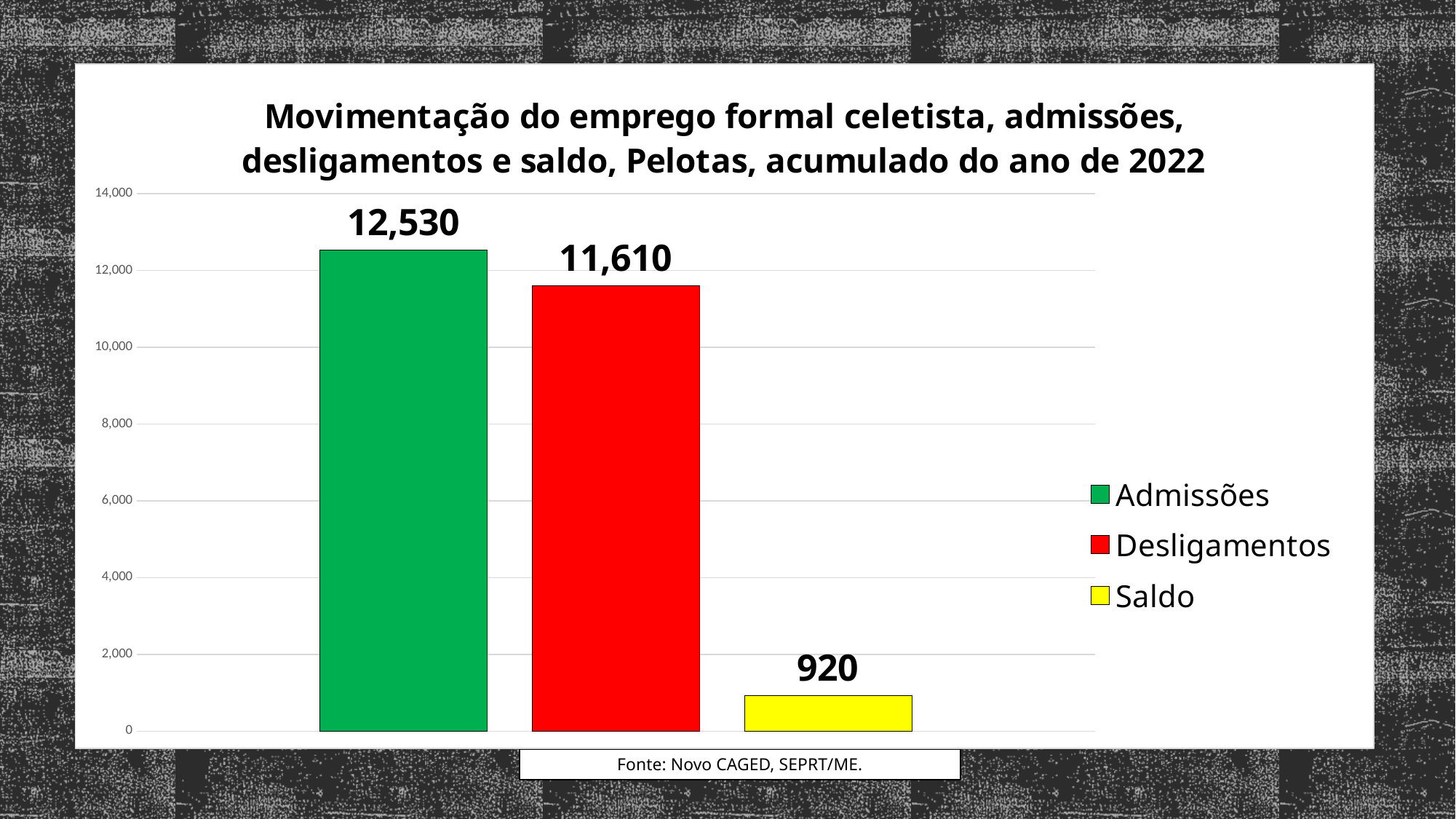
What colour is the bar for Saldo? yellow What is the difference between Admissões and Desligamentos? 920 What is the value for Saldo? 920 Which category has the highest value? Admissões What kind of chart is shown on the slide? bar chart Which category has the lowest value? Saldo Is the value for Desligamentos greater or less than 12,000? less What is the value for Desligamentos? 11,610 How many bars are plotted in the chart? 3 How many entries does the legend list? 3 Which is larger, Desligamentos or Saldo? Desligamentos What is the value for Admissões? 12,530